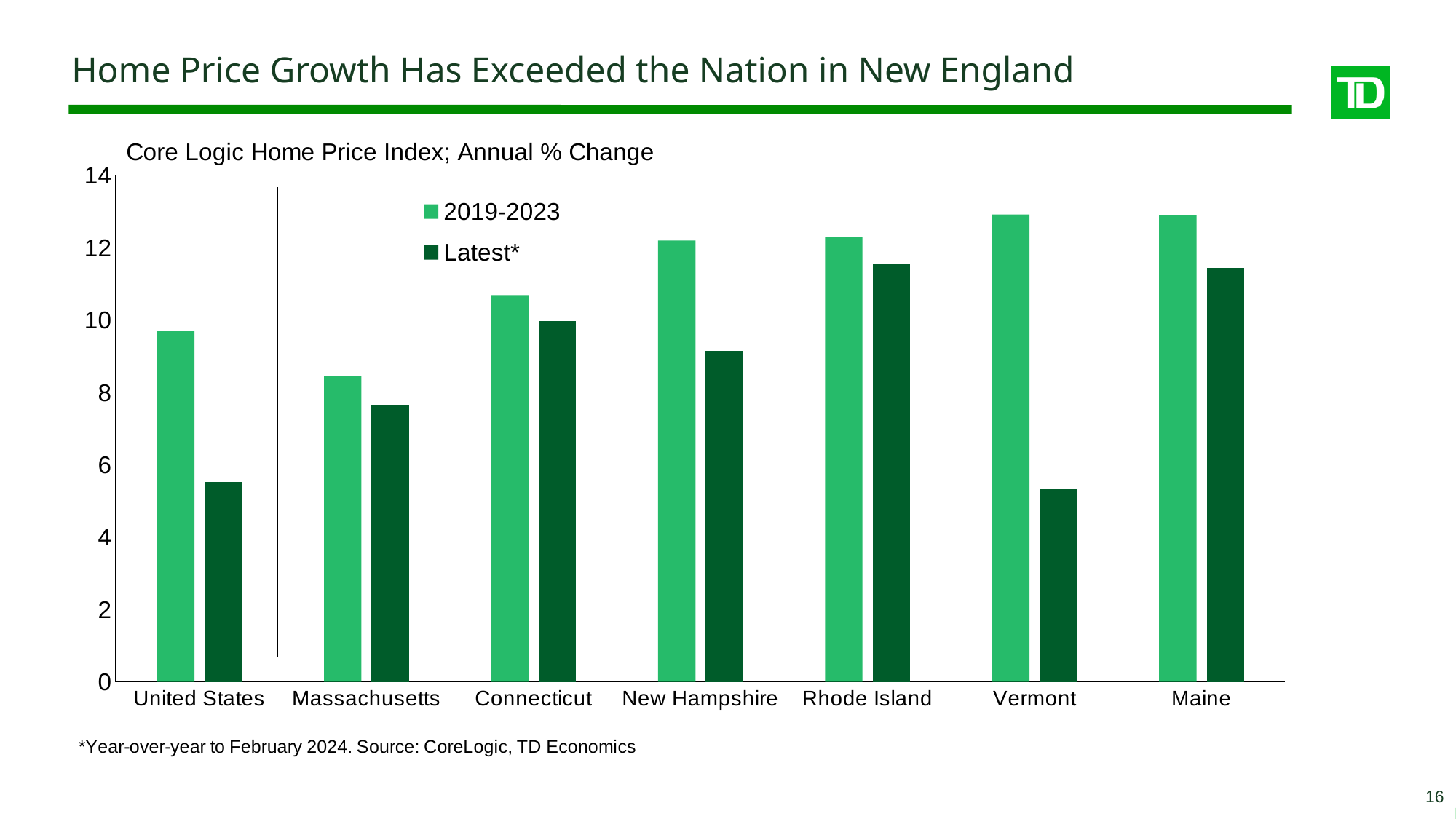
Is the 2019-2023 value for Rhode Island greater or less than 12? greater How many categories are shown on the x axis? 7 Is the 2019-2023 value for United States greater or less than 10? less Is the Latest* value for Massachusetts greater or less than 8? less Which category has the lowest 2019-2023 value? Massachusetts What kind of chart is shown on the slide? Bar chart What is the subtitle printed above the chart? Core Logic Home Price Index; Annual % Change How many series does the legend list? 2 Which is larger, the Latest* value for Vermont or the Latest* value for Massachusetts? Massachusetts Which is larger, the 2019-2023 value for Connecticut or the 2019-2023 value for New Hampshire? New Hampshire